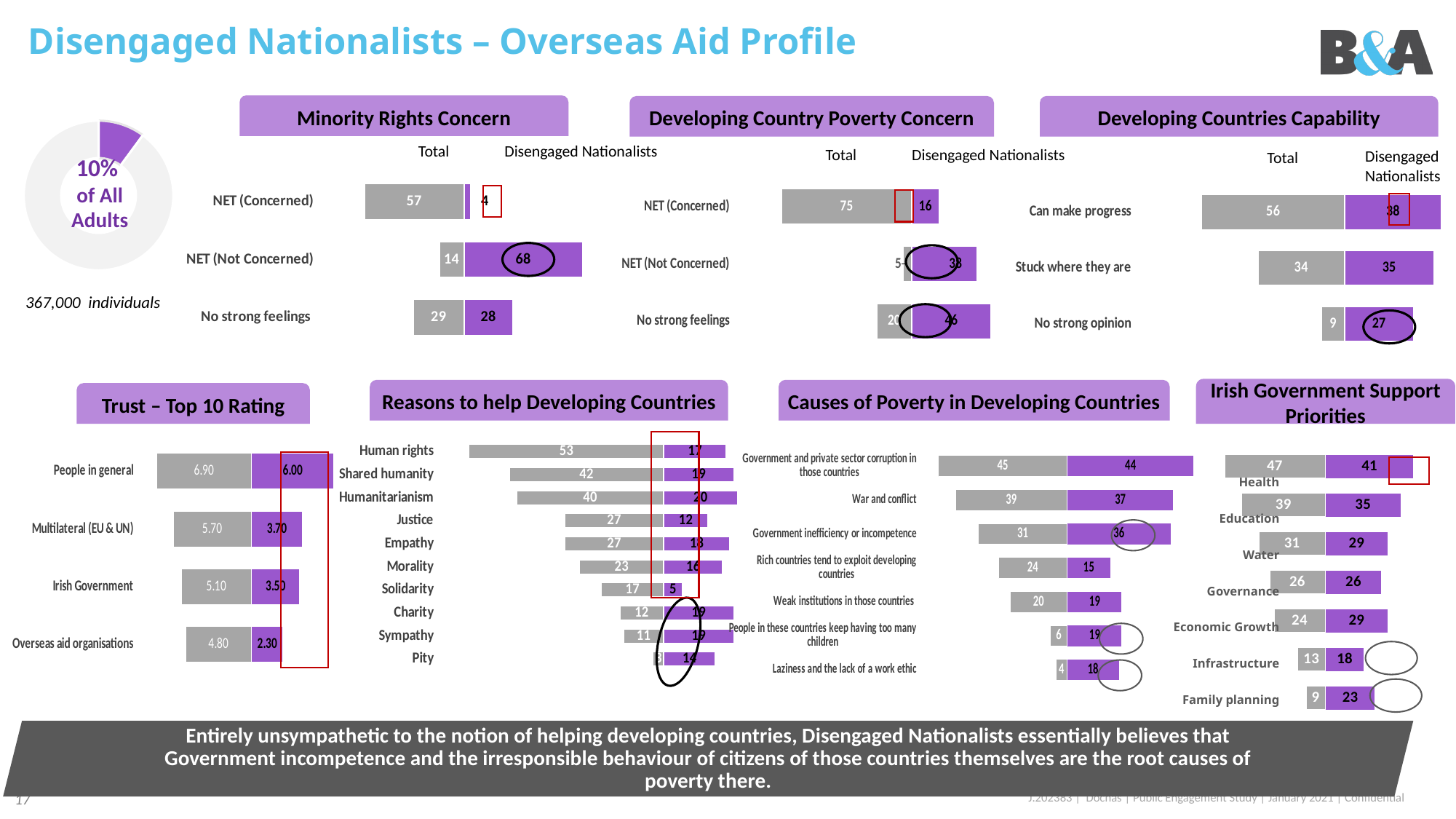
According to the donut chart, what share of all adults are Disengaged Nationalists? 10% In the Irish Government Support Priorities chart, what is the Disengaged Nationalists value for Family planning? 23 In the Developing Countries Capability chart, what is the difference between the Total and Disengaged Nationalists values for No strong opinion? 18 In the Causes of Poverty in Developing Countries chart, which is larger for War and conflict: the Total value or the Disengaged Nationalists value? Total In the Causes of Poverty in Developing Countries chart, what is the Disengaged Nationalists value for Laziness and the lack of a work ethic? 18 In the Trust – Top 10 Rating chart, which category has the highest Total rating? People in general In the Reasons to help Developing Countries chart, how many reasons are listed? 10 In the Minority Rights Concern chart, what is the Total value for NET (Concerned)? 57 In the Trust – Top 10 Rating chart, what is the Disengaged Nationalists rating for Overseas aid organisations? 2.30 In the Minority Rights Concern chart, what is the Disengaged Nationalists value for NET (Not Concerned)? 68 In the Developing Country Poverty Concern chart, what is the Disengaged Nationalists value for No strong feelings? 46 In the Reasons to help Developing Countries chart, which reason has the lowest Disengaged Nationalists value? Solidarity